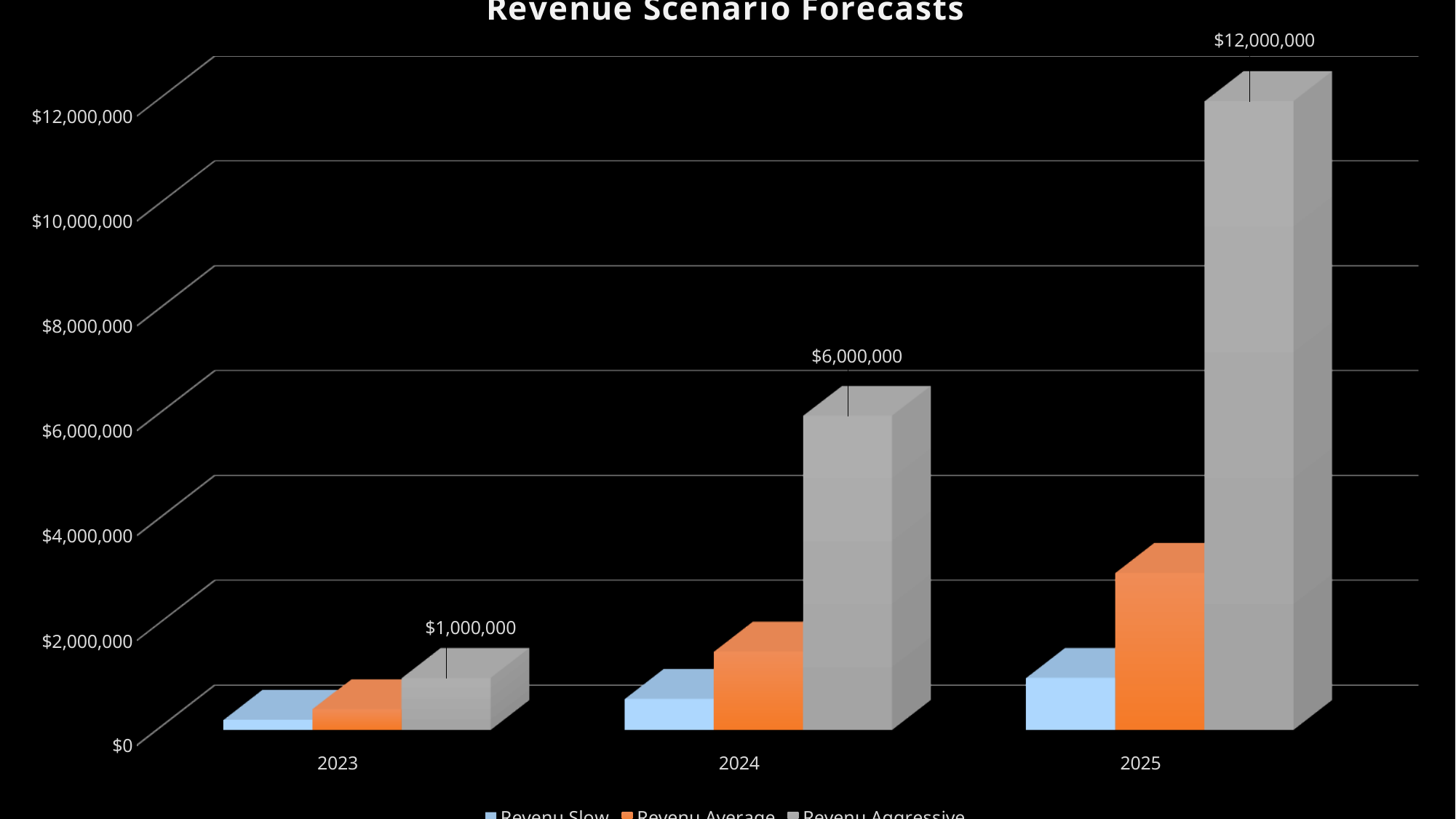
Which year has the lowest Revenu Aggressive value? 2023 Does the Revenu Aggressive value rise or fall from 2023 to 2025? rise Which year has the highest Revenu Aggressive value? 2025 What is the Revenu Aggressive value for 2024? $6,000,000 How many years are shown on the x axis? 3 Is the Revenu Slow value for 2024 greater or less than $2,000,000? less How many series does the legend list? 3 What is the Revenu Aggressive value for 2025? $12,000,000 What is the Revenu Aggressive value for 2023? $1,000,000 Is the Revenu Average value for 2025 greater or less than $2,000,000? greater What is the difference between the Revenu Aggressive values for 2025 and 2024? $6,000,000 What is the difference between the Revenu Aggressive values for 2024 and 2023? $5,000,000